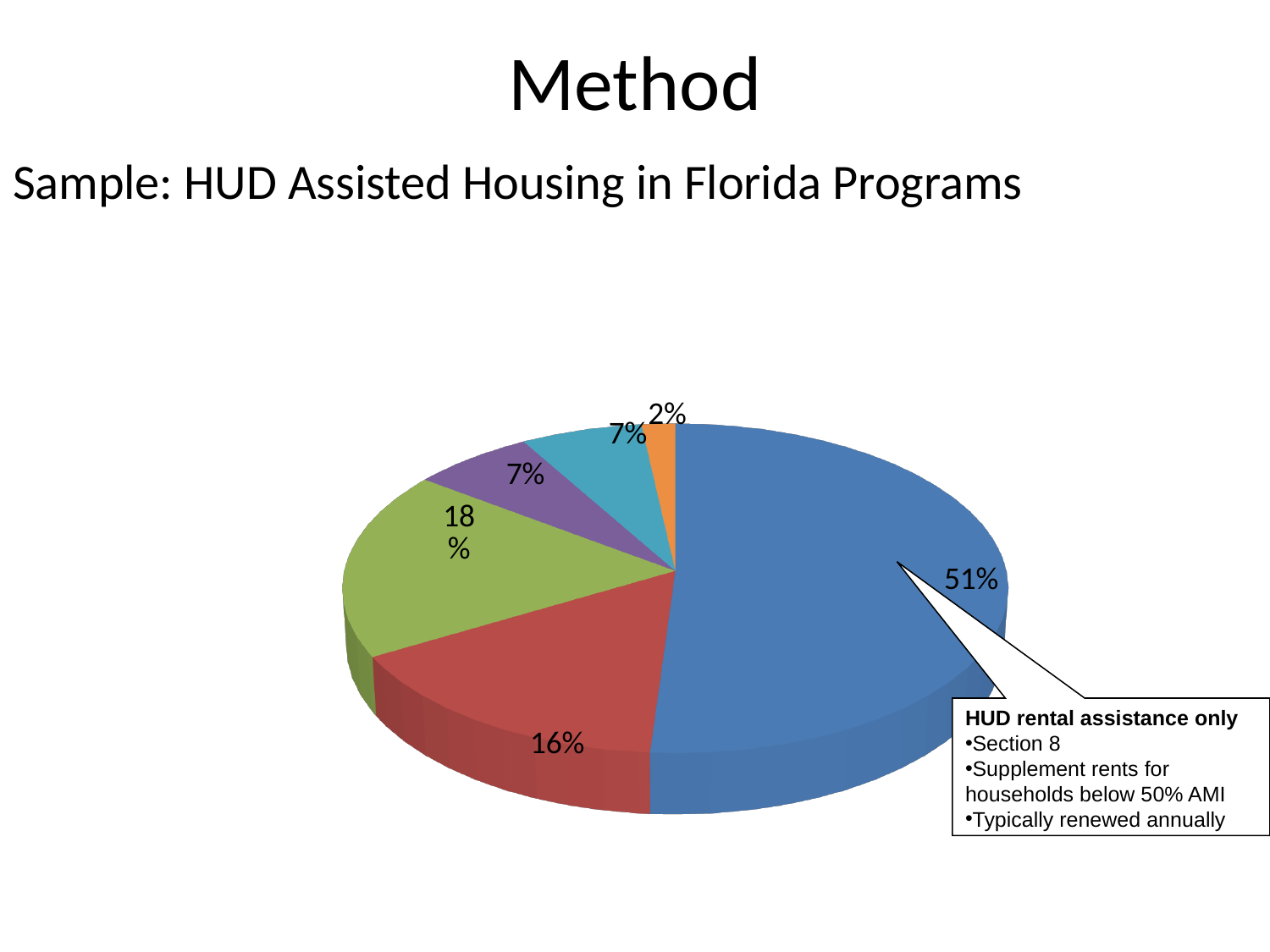
What colour is the slice that the callout box 'HUD rental assistance only' points to? blue What is the largest slice of the pie chart? 51% What percentage is shown on the orange slice of the pie chart? 2% What percentage is shown on the green slice of the pie chart? 18% How many slices does the pie chart have? 6 What kind of chart is shown on the slide? pie chart Which is larger, the green slice or the red slice? the green slice (18%) What is the smallest slice of the pie chart? 2% What is the difference between the HUD rental assistance only slice (51%) and the green slice (18%)? 33% What share of the pie is labelled as HUD rental assistance only? 51% Is the HUD rental assistance only slice more or less than half of the pie? more What percentage is shown on the red slice of the pie chart? 16%